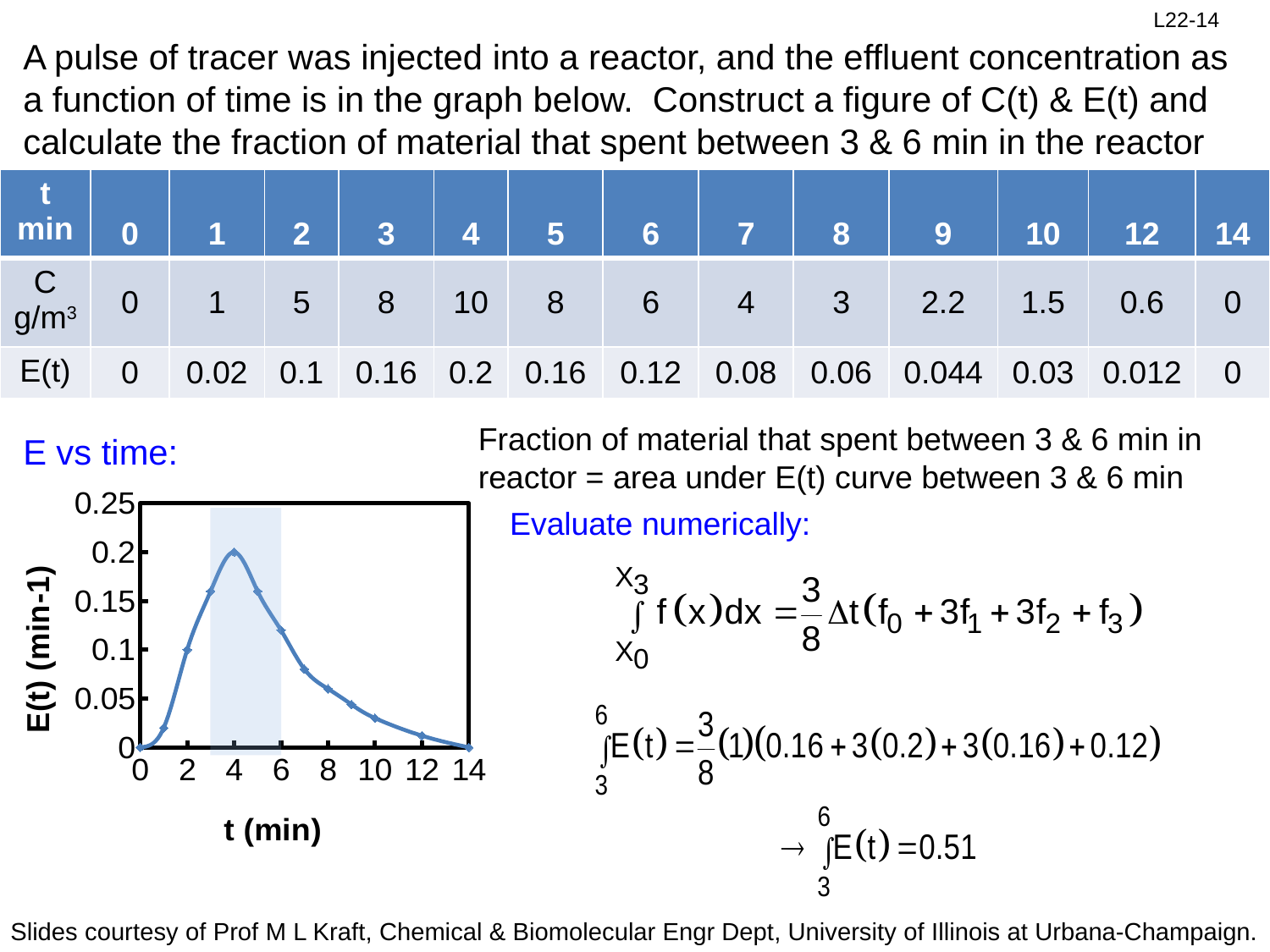
In the 'E vs time' chart, what is the value of E(t) at t = 4 min? 0.2 In the 'E vs time' chart, is the value of E(t) at t = 6 min greater or less than 0.1? greater In the 'E vs time' chart, does E(t) rise or fall as t increases from 4 min to 14 min? fall In the 'E vs time' chart, which has the larger E(t) value: t = 3 min or t = 7 min? t = 3 min What kind of chart is the 'E vs time' chart? line chart In the 'E vs time' chart, what is the difference between E(t) at t = 4 min and E(t) at t = 2 min? 0.1 In the 'E vs time' chart, what is the value of E(t) at t = 2 min? 0.1 What is the label of the x axis of the 'E vs time' chart? t (min) In the 'E vs time' chart, what is the value of E(t) at t = 14 min? 0 In the 'E vs time' chart, is the value of E(t) at t = 1 min greater or less than 0.05? less In the 'E vs time' chart, at which value of t (min) is E(t) highest? 4 In the 'E vs time' chart, is the value of E(t) at t = 10 min greater or less than 0.05? less